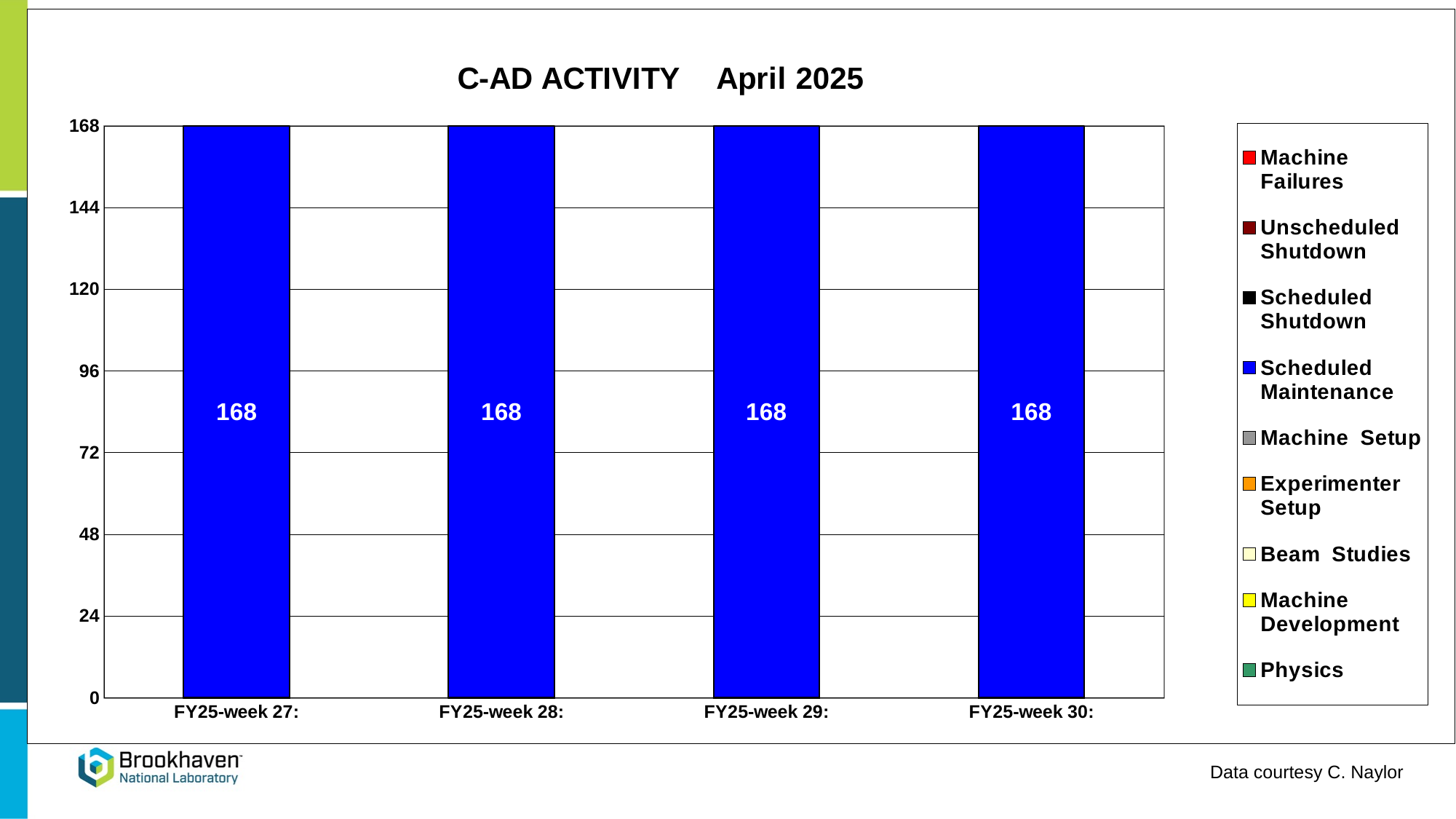
Do the values rise, fall, or stay the same from FY25-week 27 to FY25-week 30? stay the same What is the total of the stacked bar for FY25-week 30? 168 What is the value of Scheduled Maintenance for FY25-week 30? 168 What is the value shown on the bar for FY25-week 29? 168 Which legend series is shown in blue? Scheduled Maintenance What kind of chart is shown on the slide? bar chart What is the difference between the values for FY25-week 28 and FY25-week 29? 0 How many weeks (categories) are shown on the x axis? 4 Is the value for FY25-week 28 greater or less than 144? greater What is the value of Scheduled Maintenance for FY25-week 27? 168 What is the title of the chart? C-AD ACTIVITY April 2025 How many series does the legend list? 9